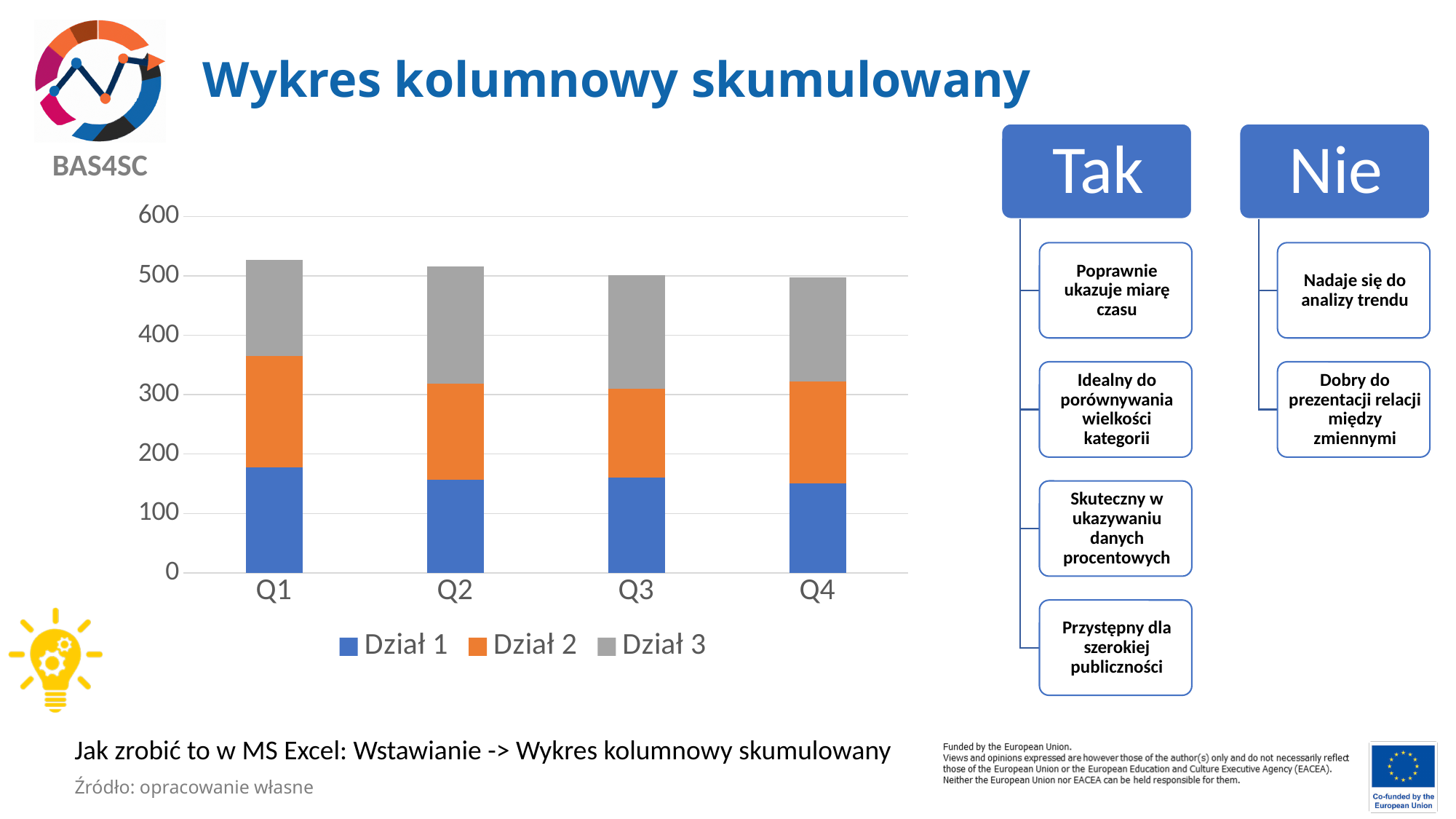
How many categories are shown on the x axis of the chart? 4 Is the value of Dział 1 for Q4 greater or less than 100? greater Is the total stacked value for Q2 greater or less than 500? greater Is the total stacked value for Q1 greater or less than 500? greater Which colour represents Dział 2 in the chart? orange Which quarter has the larger Dział 1 value, Q1 or Q4? Q1 How many series does the chart legend list? 3 Do the total stacked bar heights rise or fall from Q1 to Q4? fall Which quarter has the highest total stacked bar? Q1 What kind of chart is shown on the slide? stacked bar chart What are the series names listed in the chart legend? Dział 1, Dział 2, Dział 3